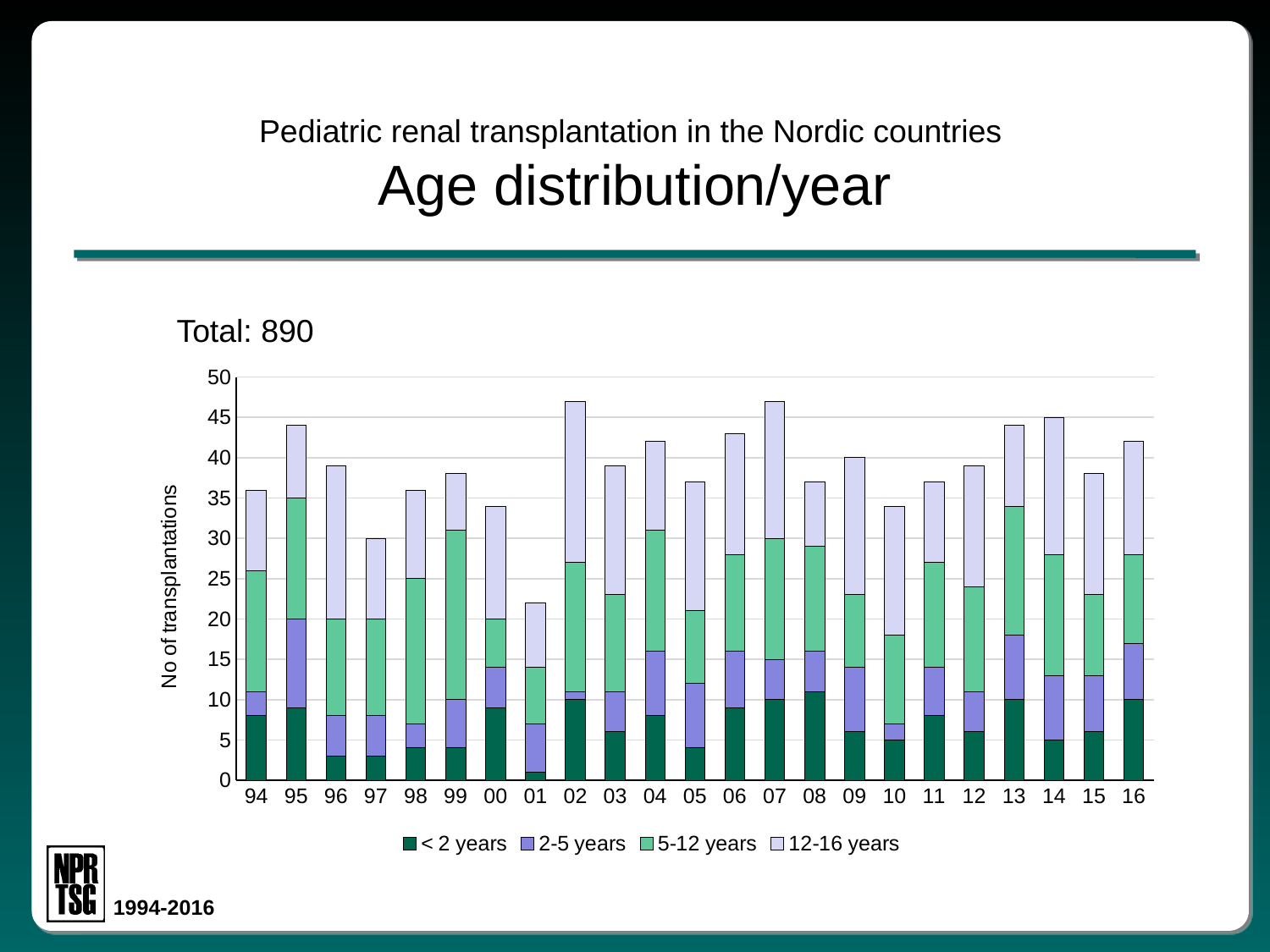
Which year has the lowest total number of transplantations? 01 What kind of chart is shown on the slide? Stacked bar chart Which year has the larger total number of transplantations, 01 or 10? 10 What is the label on the y axis of the chart? No of transplantations Is the total number of transplantations in 97 greater or less than 35? less How many years (bars) are shown along the x axis? 23 Which year has the larger total number of transplantations, 95 or 97? 95 Is the total number of transplantations in 02 greater or less than 45? greater Is the total number of transplantations in 01 greater or less than 25? less What overall total is stated above the chart? Total: 890 How many age groups does the legend list? 4